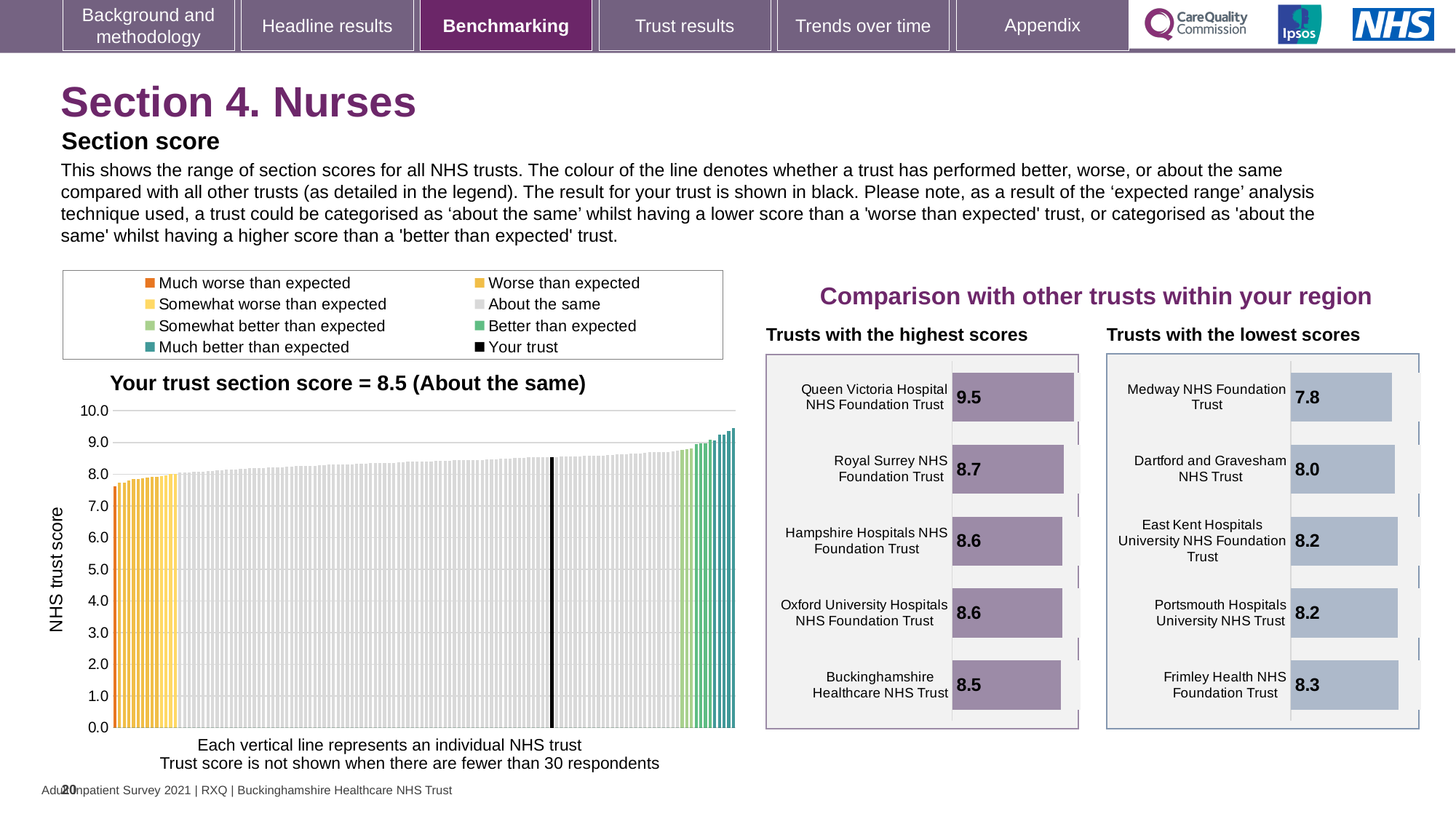
In the 'Trusts with the lowest scores' chart, what is the difference between the scores of Frimley Health NHS Foundation Trust and Medway NHS Foundation Trust? 0.5 What kind of chart is the 'Your trust section score' chart on the left of the slide? Bar chart In the 'Trusts with the lowest scores' chart, what is the score for Medway NHS Foundation Trust? 7.8 How many trusts are shown in the 'Trusts with the lowest scores' chart? 5 In the 'Trusts with the highest scores' chart, which trust has the highest score? Queen Victoria Hospital NHS Foundation Trust In the 'Trusts with the lowest scores' chart, which trust has the lowest score? Medway NHS Foundation Trust How many trusts are shown in the 'Trusts with the highest scores' chart? 5 In the 'Trusts with the highest scores' chart, what is the difference between the scores of Queen Victoria Hospital NHS Foundation Trust and Buckinghamshire Healthcare NHS Trust? 1.0 In the 'Trusts with the highest scores' chart, which has the higher score: Royal Surrey NHS Foundation Trust or Hampshire Hospitals NHS Foundation Trust? Royal Surrey NHS Foundation Trust In the 'Your trust section score' chart, is the value for the lowest-scoring trust (the leftmost bar) greater or less than 8.0? less In the 'Trusts with the highest scores' chart, what is the score for Queen Victoria Hospital NHS Foundation Trust? 9.5 How many entries does the legend above the 'Your trust section score' chart list? 8